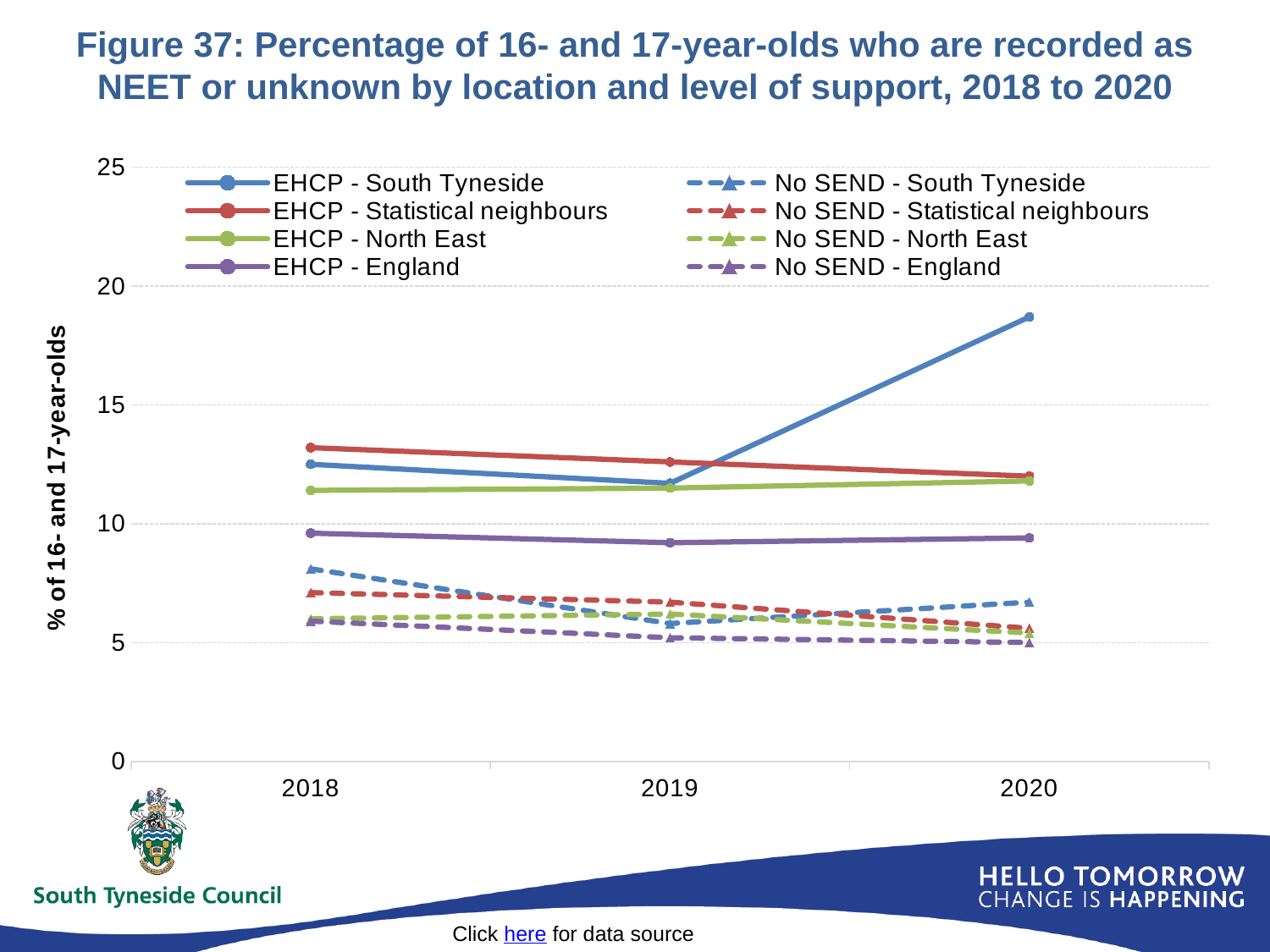
How many series does the legend list? 8 How many years are plotted along the x axis? 3 Does the No SEND - England line rise or fall from 2018 to 2020? fall What is the label on the y axis? % of 16- and 17-year-olds Which group of series is drawn with dashed lines, EHCP or No SEND? No SEND Which series has the highest value in 2020? EHCP - South Tyneside Is the value for EHCP - South Tyneside in 2020 greater or less than 15? greater In 2018, which is larger: EHCP - Statistical neighbours or EHCP - South Tyneside? EHCP - Statistical neighbours Does the EHCP - Statistical neighbours line rise or fall from 2018 to 2020? fall Is the value for EHCP - England in 2018 greater or less than 10? less What kind of chart is shown on the slide? line chart Is the value for No SEND - South Tyneside in 2018 greater or less than 10? less